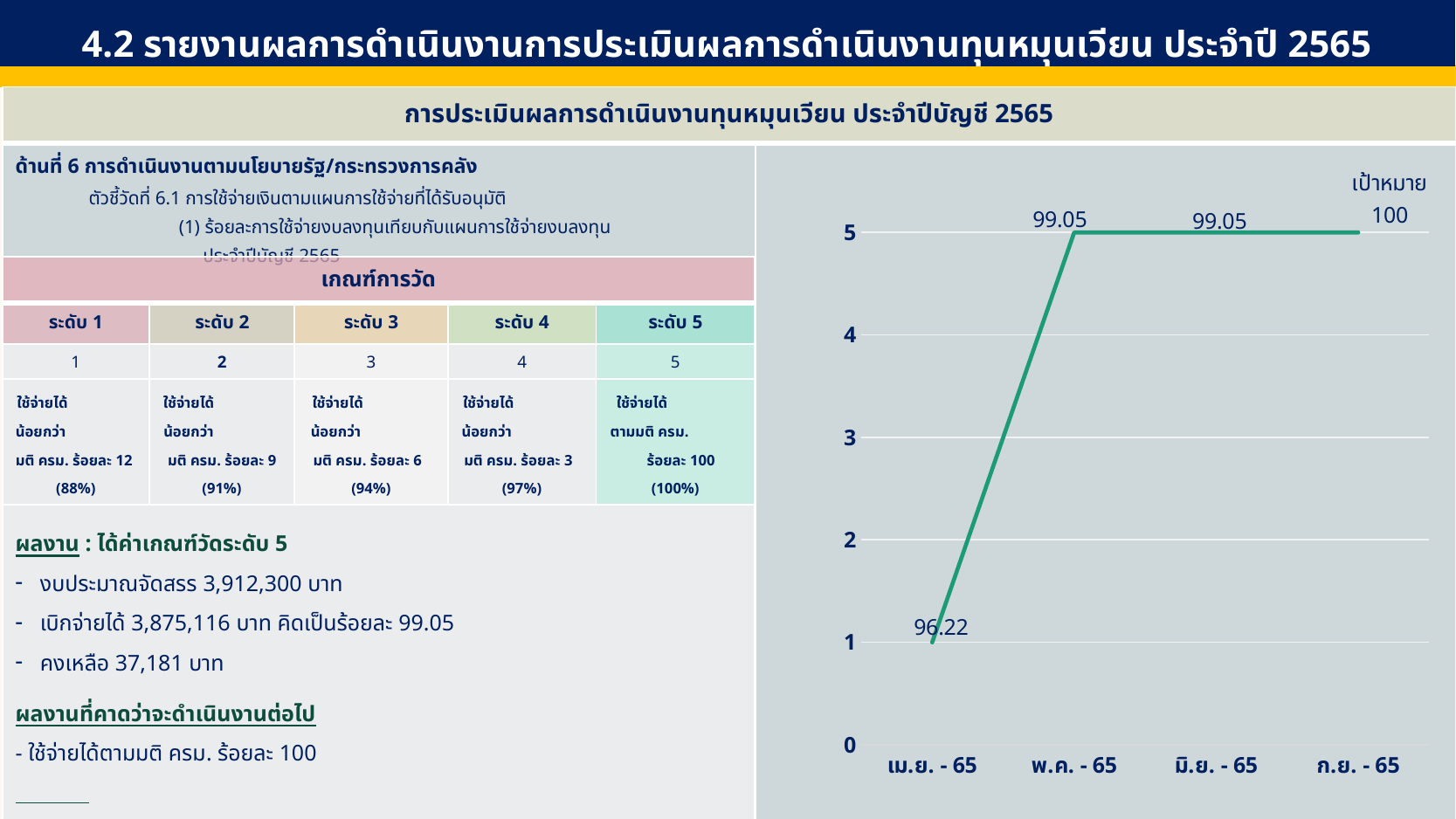
What is the data label shown for เม.ย. - 65 on the line chart? 96.22 What is the difference between the data labels for พ.ค. - 65 and เม.ย. - 65? 2.83 What kind of chart is shown on the right side of the slide? line chart Is the plotted level for ก.ย. - 65 greater or less than 4 on the y axis? greater What target value (เป้าหมาย) is labelled at ก.ย. - 65 on the line chart? 100 Is the plotted level for เม.ย. - 65 greater or less than 2 on the y axis? less Does the line rise or fall from เม.ย. - 65 to พ.ค. - 65? rise What is the data label shown for มิ.ย. - 65 on the line chart? 99.05 How many categories are shown on the x axis of the line chart? 4 Which has the larger data label, เม.ย. - 65 or มิ.ย. - 65? มิ.ย. - 65 What is the data label shown for พ.ค. - 65 on the line chart? 99.05 Which x-axis category has the lowest plotted level on the line chart? เม.ย. - 65